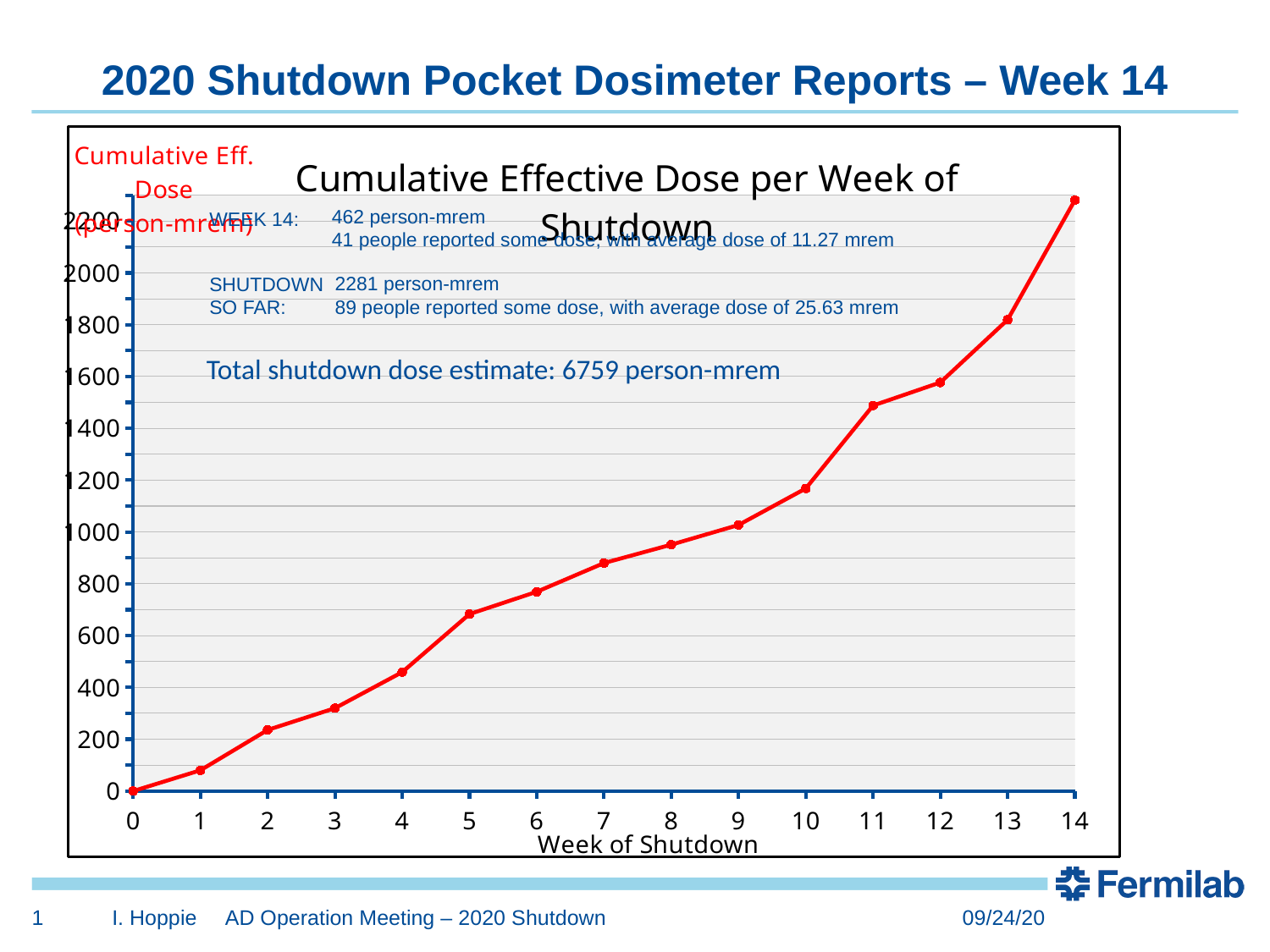
What kind of chart is shown on the slide? line chart What is the cumulative effective dose at week 0? 0 How many data points are plotted on the line (weeks 0 through 14)? 15 Is the value for week 14 greater or less than 2200? greater Which is larger, the value for week 10 or the value for week 5? week 10 Which week has the lowest cumulative effective dose? 0 Which week has the highest cumulative effective dose? 14 What is the label of the x axis of the chart? Week of Shutdown Is the value for week 5 greater or less than 600? greater Is the value for week 11 greater or less than 1600? less Do the values rise or fall as the week of shutdown increases? rise What is the title of the chart? Cumulative Effective Dose per Week of Shutdown